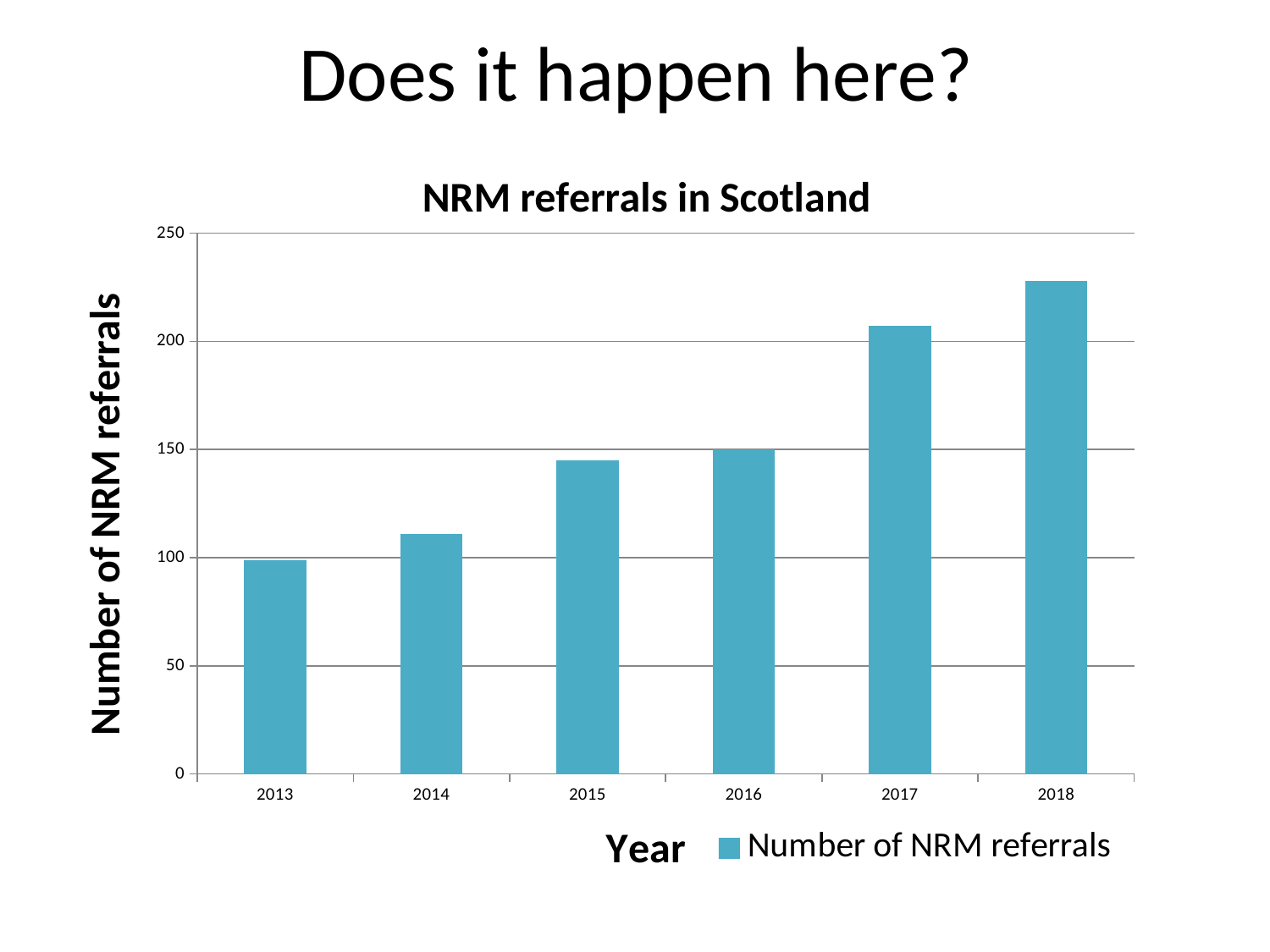
Which year has the highest number of NRM referrals? 2018 What type of chart is shown on the slide? bar chart Do the number of NRM referrals rise or fall from 2013 to 2018? rise What is the title of the chart? NRM referrals in Scotland How many years are shown on the x axis of the chart? 6 Is the value for 2017 greater or less than 200? greater Which year has the lowest number of NRM referrals? 2013 Which year has more NRM referrals, 2015 or 2017? 2017 What is the label of the y axis? Number of NRM referrals Is the value for 2014 greater or less than 100? greater Is the value for 2015 greater or less than 150? less How many series does the legend list? 1